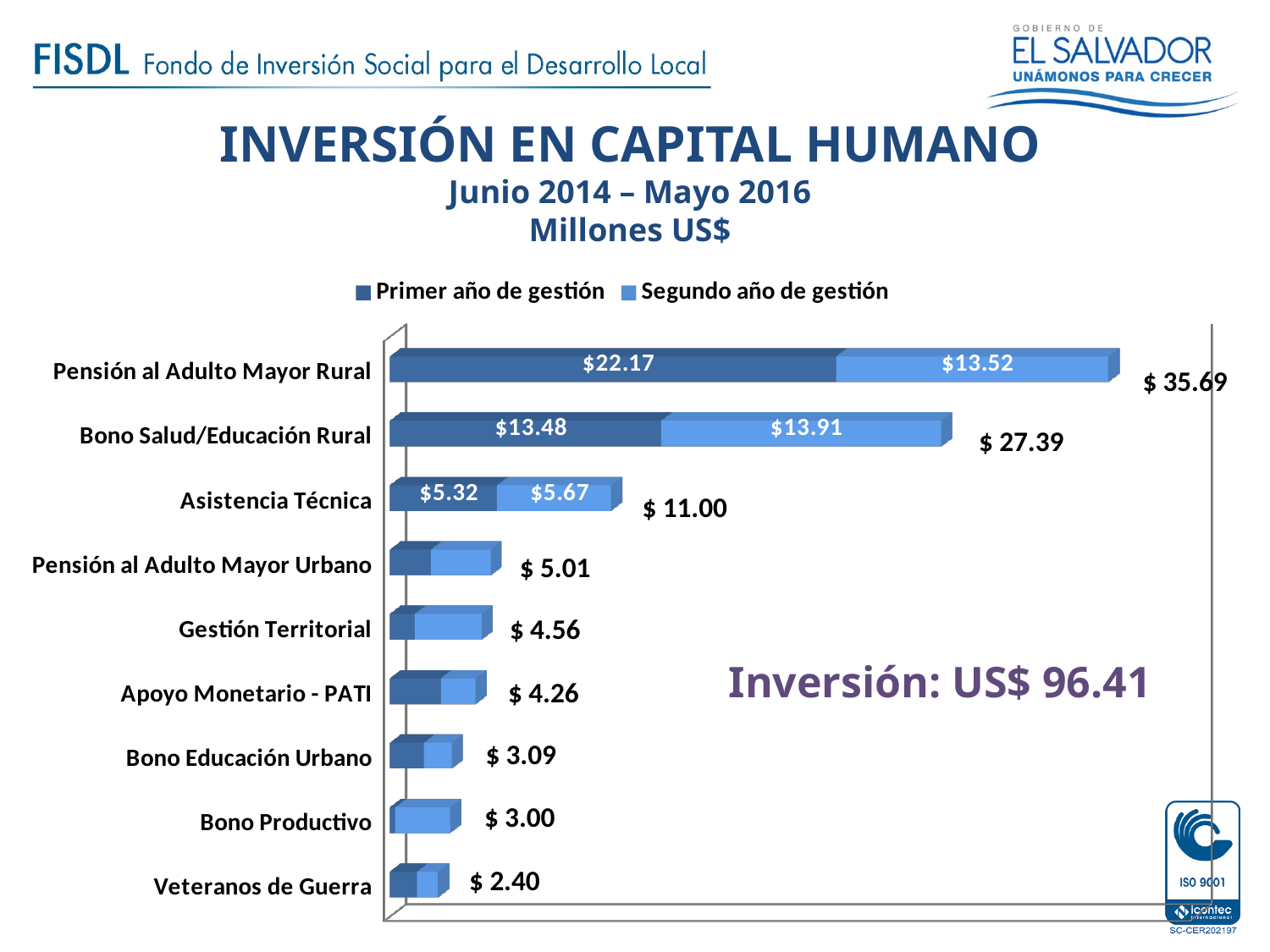
What is the difference between the total for Pensión al Adulto Mayor Rural and the total for Bono Salud/Educación Rural? $ 8.30 What is the value for Segundo año de gestión for Bono Salud/Educación Rural? $13.91 Which has a larger total value, Gestión Territorial or Apoyo Monetario - PATI? Gestión Territorial How many categories are shown in the chart? 9 Which category has the highest total value? Pensión al Adulto Mayor Rural How many series does the legend list? 2 What is the total value shown for Bono Productivo? $ 3.00 What is the value for Primer año de gestión for Pensión al Adulto Mayor Rural? $22.17 Which category has the lowest total value? Veteranos de Guerra What is the total value shown for Asistencia Técnica? $ 11.00 What kind of chart is shown on the slide? Stacked bar chart For Asistencia Técnica, how much larger is the Segundo año de gestión value than the Primer año de gestión value? $0.35